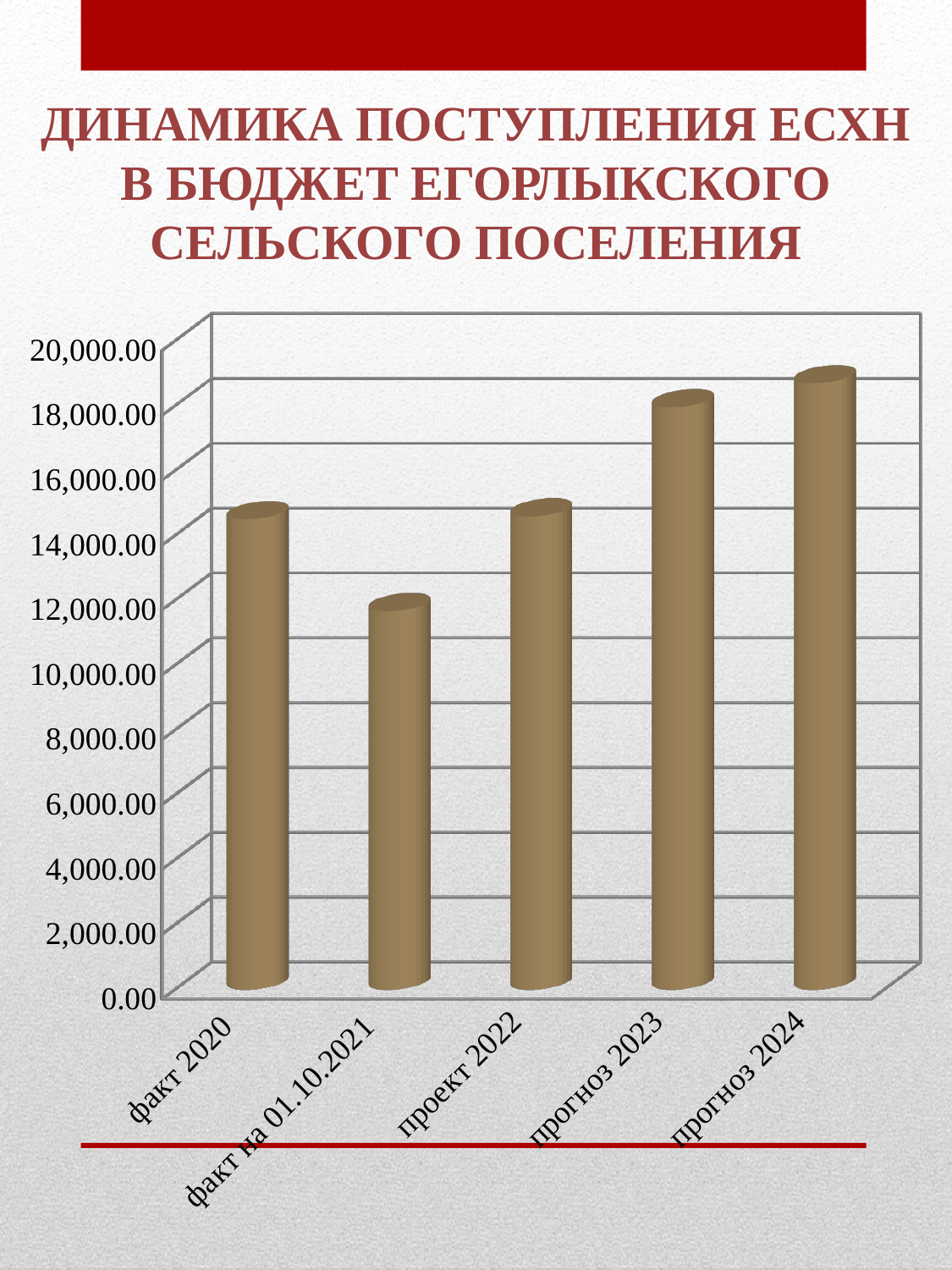
Is the value for факт 2020 greater or less than 16,000.00? less Is the value for прогноз 2024 greater or less than 20,000.00? less Is the value for факт 2020 greater or less than 14,000.00? greater Which is larger, the value for прогноз 2023 or the value for факт на 01.10.2021? прогноз 2023 Which category has the highest value in the chart? прогноз 2024 What is the title of the chart on the slide? ДИНАМИКА ПОСТУПЛЕНИЯ ЕСХН В БЮДЖЕТ ЕГОРЛЫКСКОГО СЕЛЬСКОГО ПОСЕЛЕНИЯ How many categories are shown on the x axis of the chart? 5 What type of chart is shown on the slide? bar chart Which category has the lowest value in the chart? факт на 01.10.2021